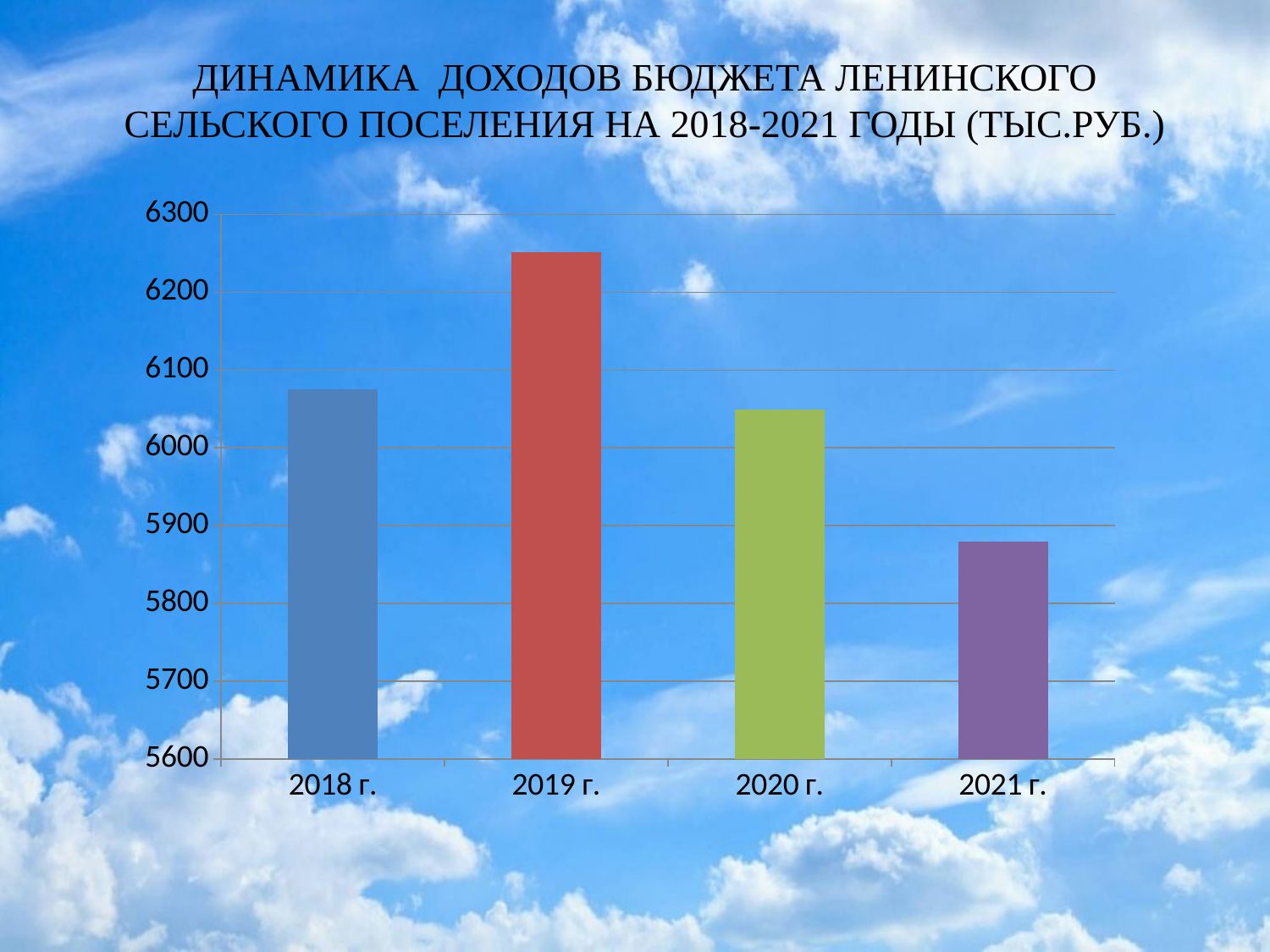
What is the lowest value shown on the vertical axis of the chart? 5600 Is the value for 2020 г. greater or less than 6100? less Is the value for 2021 г. greater or less than 6000? less Is the value for 2018 г. greater or less than 6000? greater From 2019 г. to 2021 г., do the values rise or fall? fall How many years (categories) are shown on the x axis of the chart? 4 Which year has the lowest budget income in the chart? 2021 г. What kind of chart is shown on the slide? bar chart Which is larger, the value for 2019 г. or the value for 2021 г.? 2019 г. Which is larger, the value for 2020 г. or the value for 2021 г.? 2020 г. Which year has the highest budget income in the chart? 2019 г.